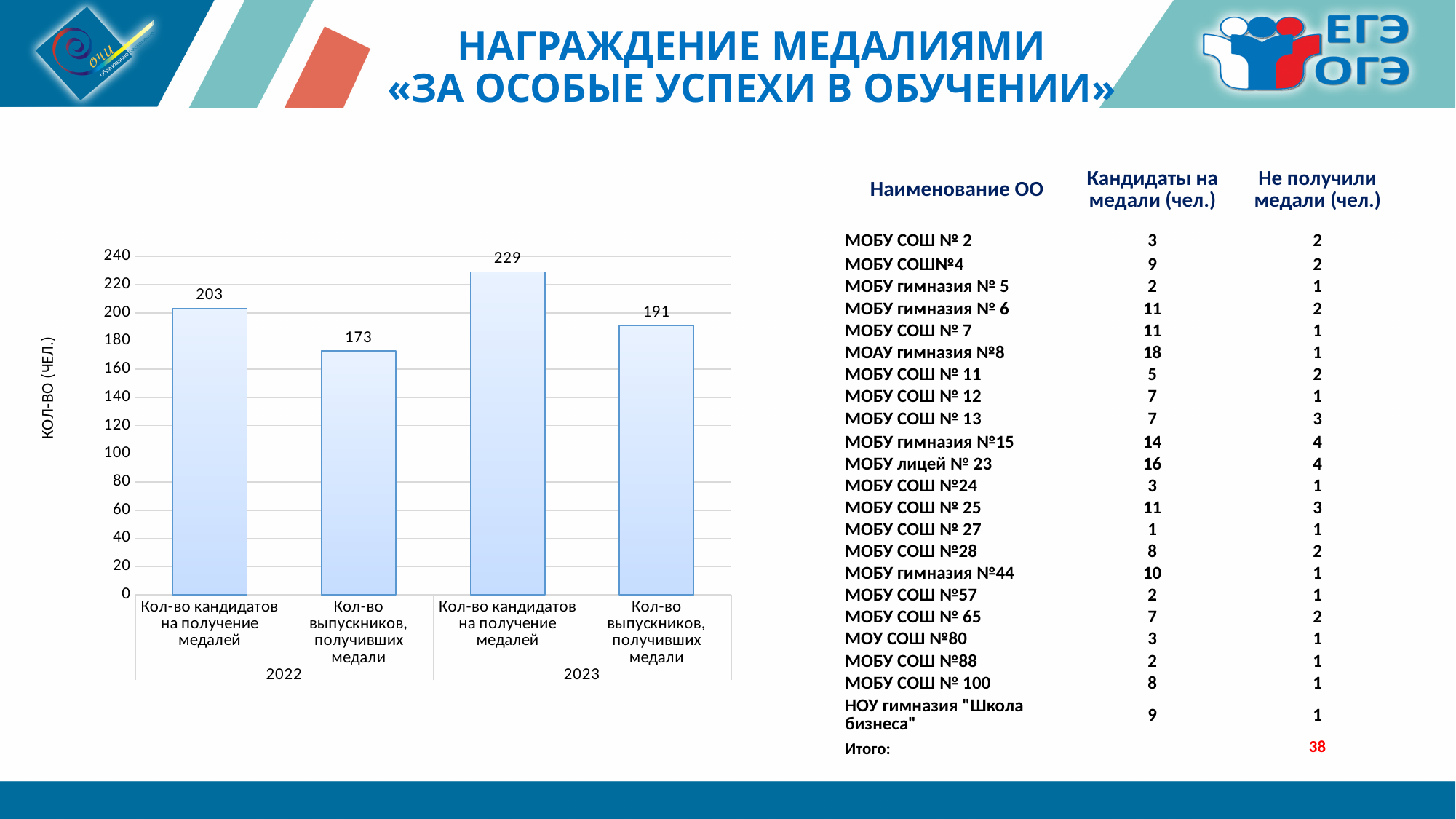
What is the label of the vertical axis of the chart? КОЛ-ВО (ЧЕЛ.) What is the number of candidates for medals (Кол-во кандидатов на получение медалей) in 2022? 203 How many bars are plotted on the chart? 4 Which bar has the lowest value on the chart? Кол-во выпускников, получивших медали, 2022 What is the difference between the number of candidates for medals in 2023 and in 2022? 26 What is the difference between the number of candidates for medals and the number of graduates who received medals in 2023? 38 What type of chart is shown on the slide? bar chart What is the number of graduates who received medals (Кол-во выпускников, получивших медали) in 2023? 191 Which bar has the highest value on the chart? Кол-во кандидатов на получение медалей, 2023 Is the value for graduates who received medals in 2022 greater or less than 180? less Which is larger: the number of graduates who received medals in 2022 or in 2023? 2023 What is the number of candidates for medals in 2023? 229